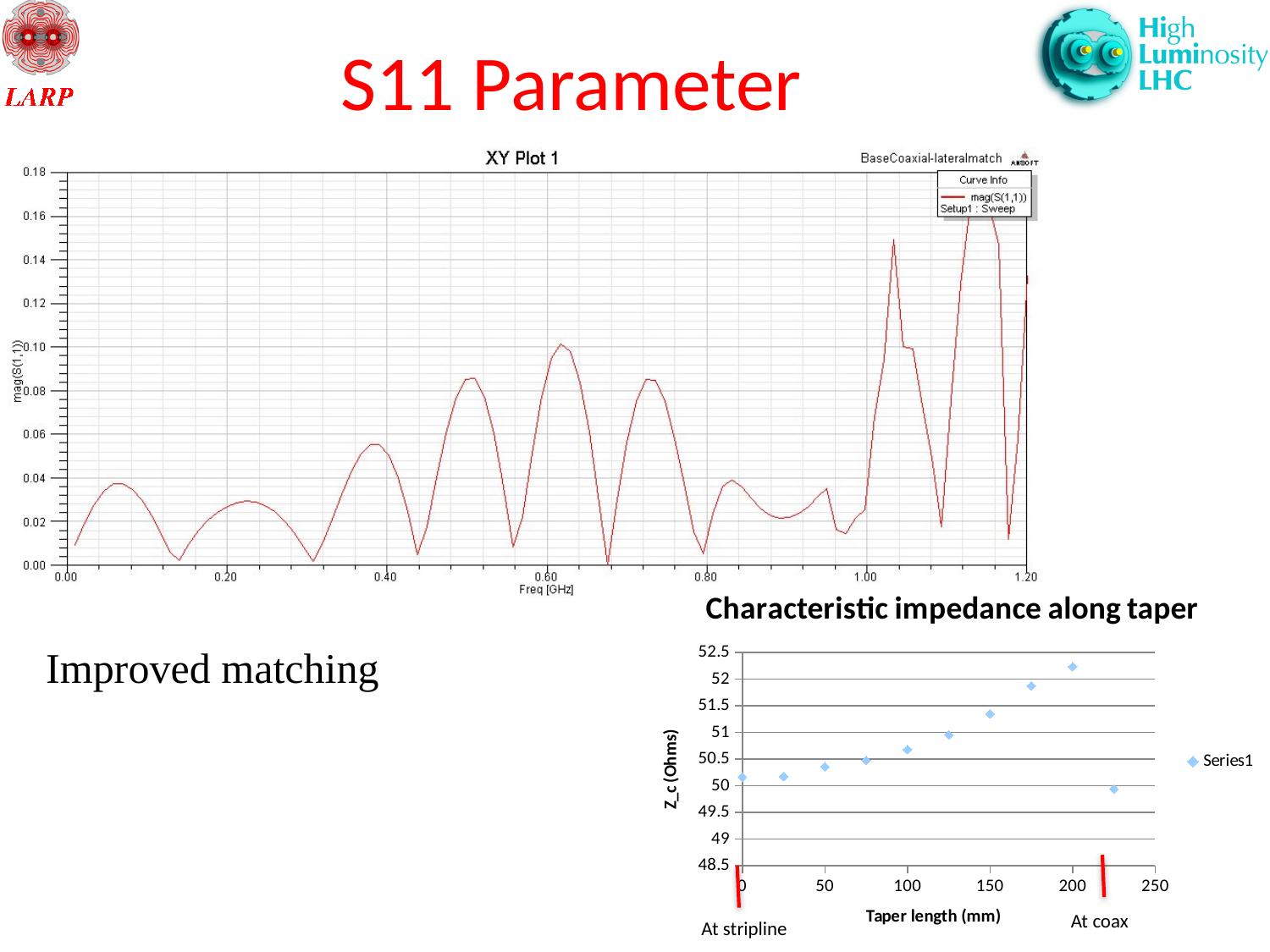
In the 'Characteristic impedance along taper' chart, at which taper length is the impedance lowest? 225 In 'XY Plot 1', is the value of mag(S(1,1)) at 1.00 GHz greater or less than 0.06? less What kind of chart is 'XY Plot 1'? line chart In the 'Characteristic impedance along taper' chart, do the values rise or fall as taper length increases from 0 to 200 mm? rise In the 'Characteristic impedance along taper' chart, which has the larger impedance: the point at 200 mm or the point at 225 mm? 200 mm In the 'Characteristic impedance along taper' chart, at which taper length is the impedance highest? 200 In the 'Characteristic impedance along taper' chart, how many data points are plotted? 10 How many series does the legend of the 'Characteristic impedance along taper' chart list? 1 What is the y-axis title of the 'Characteristic impedance along taper' chart? Z_c (Ohms) What kind of chart is the 'Characteristic impedance along taper' chart? scatter chart In the 'Characteristic impedance along taper' chart, is the value at a taper length of 150 mm greater or less than 51? greater In the 'Characteristic impedance along taper' chart, is the value at a taper length of 175 mm greater or less than 51.5? greater